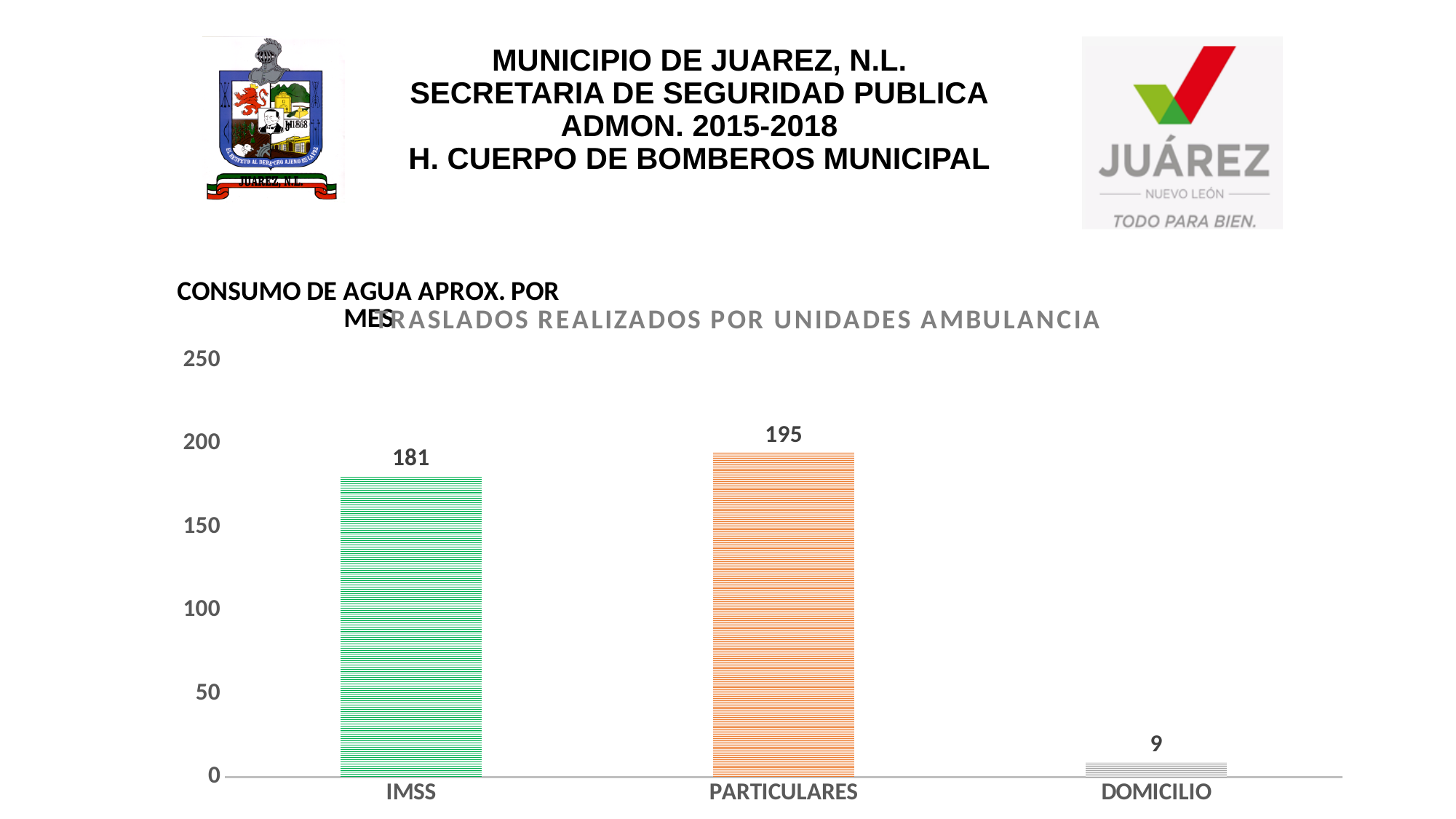
Which category has the lowest value? DOMICILIO What kind of chart is shown on the slide? bar chart Which is larger, the value for IMSS or the value for PARTICULARES? PARTICULARES What is the value for DOMICILIO in the chart? 9 What is the value for IMSS in the chart? 181 What is the title of the chart? TRASLADOS REALIZADOS POR UNIDADES AMBULANCIA How many categories are shown in the chart? 3 Which category has the highest value? PARTICULARES What is the value for PARTICULARES in the chart? 195 What is the difference between the values for PARTICULARES and IMSS? 14 What is the difference between the values for IMSS and DOMICILIO? 172 Is the value for IMSS greater or less than 150? greater